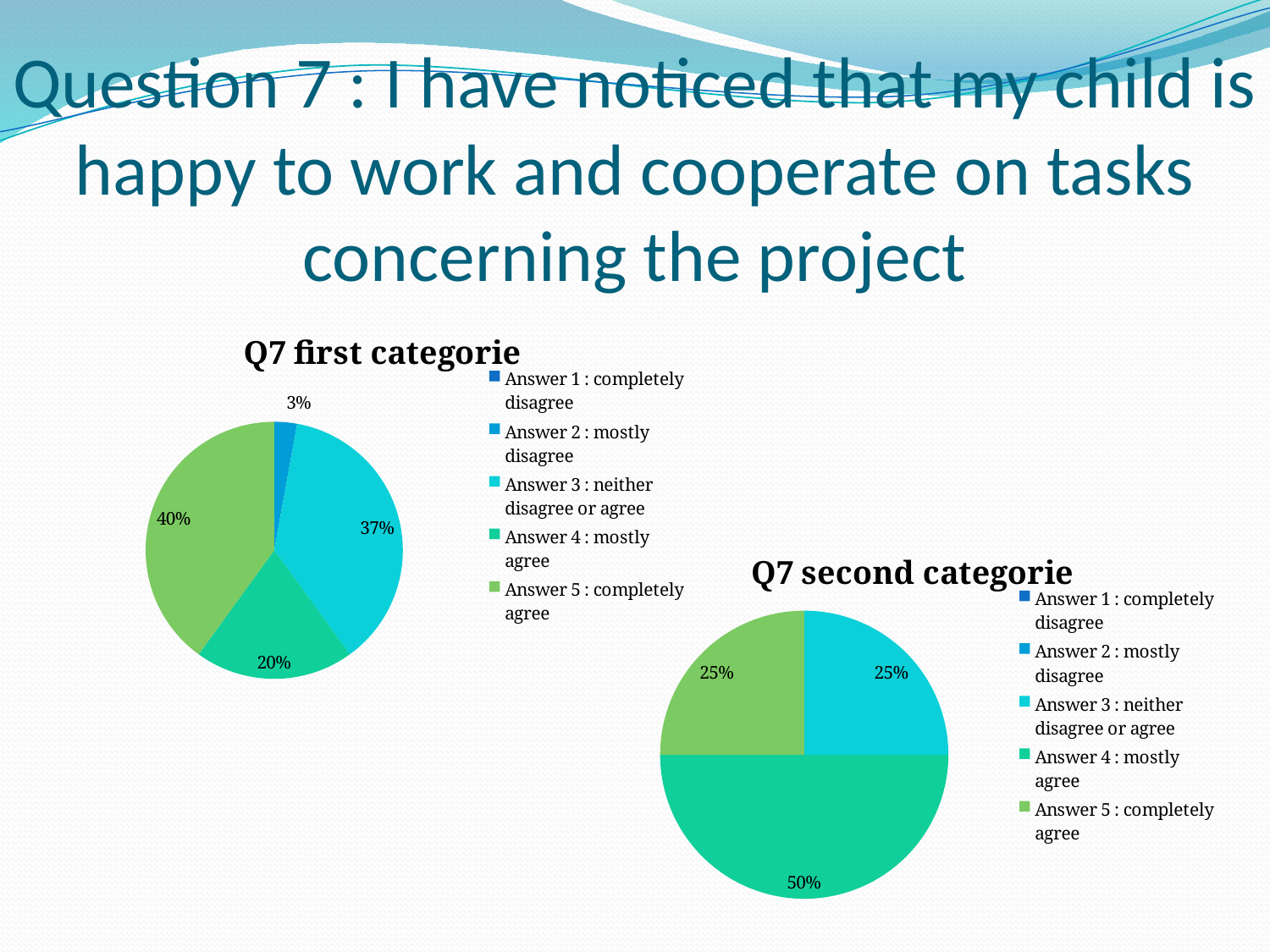
In the 'Q7 second categorie' pie chart, what share is shown for Answer 4 : mostly agree? 50% In the 'Q7 first categorie' pie chart, what is the smallest percentage labelled on a slice? 3% How many entries does the legend of the 'Q7 second categorie' chart list? 5 In the 'Q7 second categorie' pie chart, which answer has the largest slice? Answer 4 : mostly agree In the 'Q7 second categorie' pie chart, what share is shown for Answer 3 : neither disagree or agree? 25% In the 'Q7 first categorie' pie chart, which answer has the largest slice? Answer 5 : completely agree What type of chart is 'Q7 first categorie'? Pie chart In the 'Q7 first categorie' pie chart, what share is shown for Answer 5 : completely agree? 40% In the 'Q7 first categorie' pie chart, what is the difference between the shares for Answer 5 : completely agree and Answer 4 : mostly agree? 20% In the 'Q7 first categorie' pie chart, what share is shown for Answer 3 : neither disagree or agree? 37% Which is larger in the 'Q7 second categorie' pie chart: the slice for Answer 4 : mostly agree or the slice for Answer 5 : completely agree? Answer 4 : mostly agree In the 'Q7 first categorie' pie chart, what share is shown for Answer 4 : mostly agree? 20%